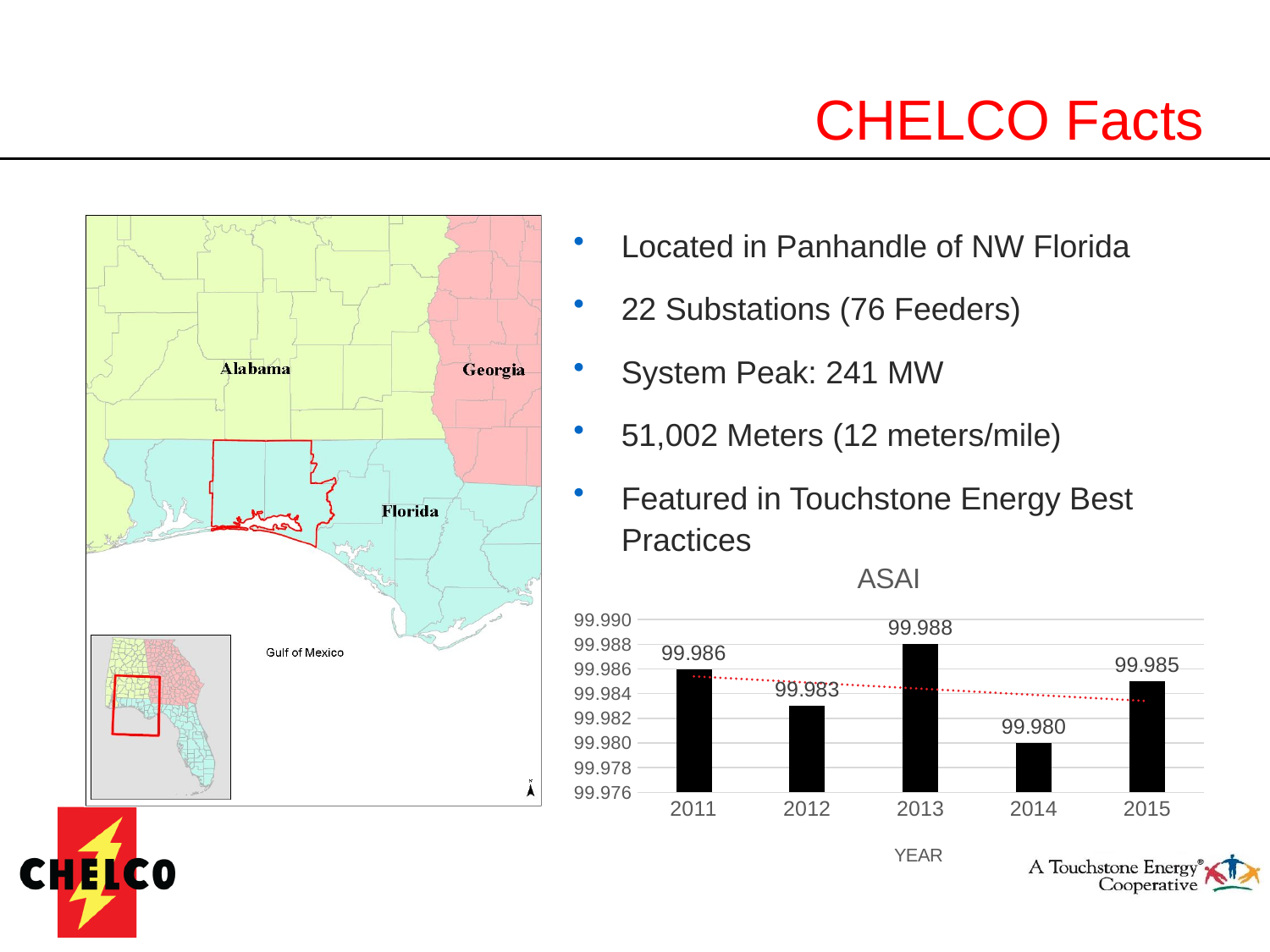
How many years are shown in the ASAI chart? 5 Which year has a higher ASAI value, 2012 or 2015? 2015 What kind of chart is the ASAI chart? Bar chart Which year has the lowest ASAI value? 2014 What is the difference between the ASAI values for 2013 and 2014? 0.008 What is the title of the chart on the slide? ASAI What is the ASAI value for 2013? 99.988 What is the ASAI value for 2015? 99.985 What is the ASAI value for 2014? 99.980 What is the ASAI value for 2011? 99.986 What is the x-axis label of the ASAI chart? YEAR Which year has the highest ASAI value? 2013